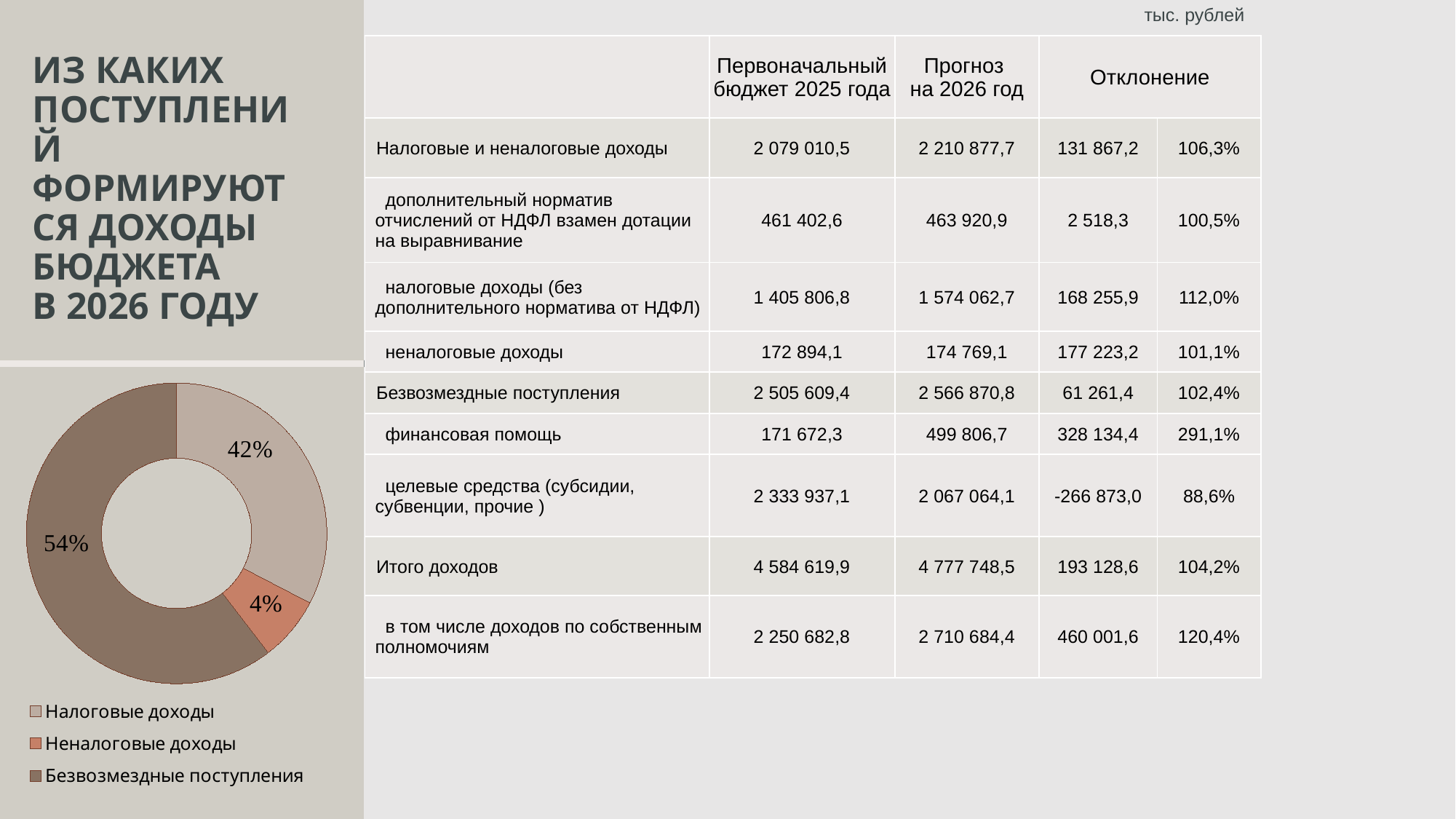
What is the difference in percentage points between the Налоговые доходы slice and the Неналоговые доходы slice? 38 What share of the doughnut chart is Неналоговые доходы? 4% What is the difference in percentage points between the Безвозмездные поступления slice and the Налоговые доходы slice? 12 How many categories does the doughnut chart show? 3 Which is larger in the doughnut chart: Налоговые доходы or Безвозмездные поступления? Безвозмездные поступления How many entries does the legend of the doughnut chart list? 3 What share of the doughnut chart is Безвозмездные поступления? 54% What share of the doughnut chart is Налоговые доходы? 42% Which category has the largest slice in the doughnut chart? Безвозмездные поступления Which category has the smallest slice in the doughnut chart? Неналоговые доходы Which legend entry of the doughnut chart is shown in the darkest brown colour? Безвозмездные поступления What kind of chart is shown on the slide? Doughnut chart